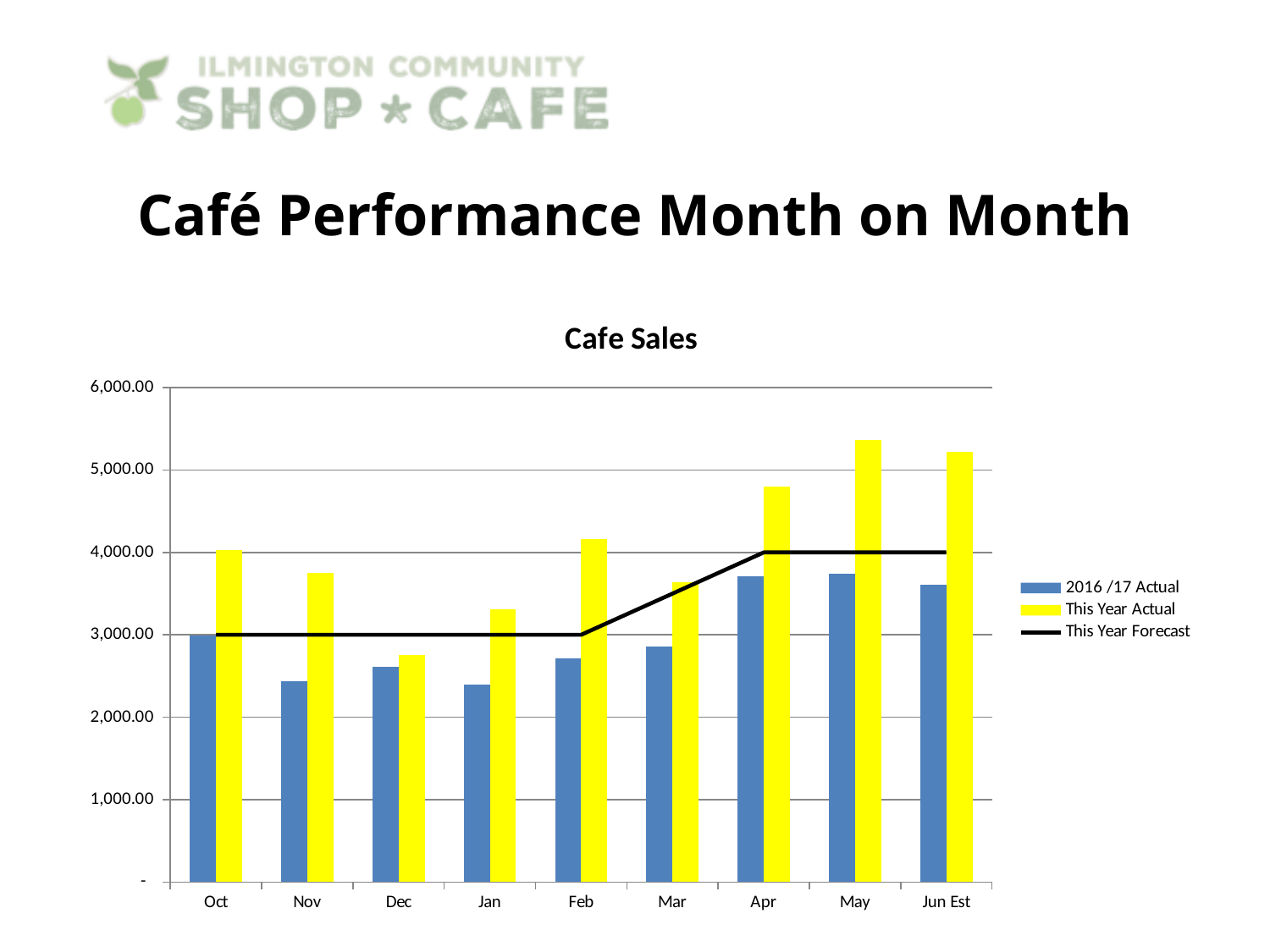
What kind of chart is the Cafe Sales chart? combination bar and line chart How many series does the legend of the Cafe Sales chart list? 3 Is the This Year Actual value for Feb greater or less than 4,000.00? greater How many months are shown on the x axis of the Cafe Sales chart? 9 In which month is This Year Actual lowest? Dec In which month is This Year Actual highest? May Is the 2016 /17 Actual value for Nov greater or less than 3,000.00? less Is the This Year Actual value for May greater or less than 5,000.00? greater What is the This Year Forecast value for May? 4,000.00 What is the This Year Forecast value for Oct? 3,000.00 In Apr, which is larger: This Year Actual or 2016 /17 Actual? This Year Actual Does the This Year Forecast line rise or fall between Feb and Apr? rise